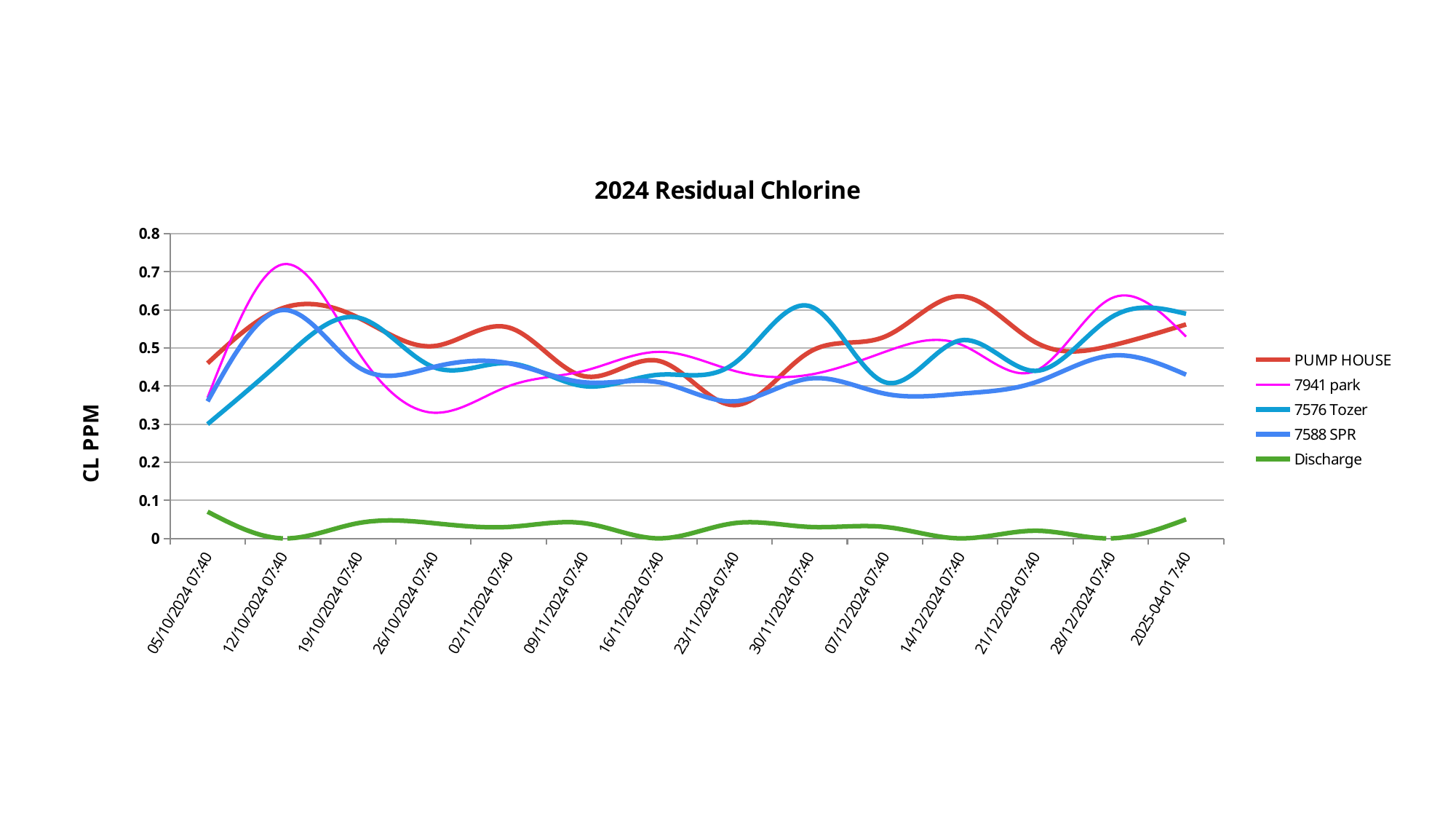
How many dates are shown along the x axis? 14 Which series has the lowest values across the whole chart? Discharge What is the label on the vertical axis? CL PPM Is the value for 7941 park at 12/10/2024 07:40 greater or less than 0.6? greater What is the title of the chart? 2024 Residual Chlorine Is the value for PUMP HOUSE at 14/12/2024 07:40 greater or less than 0.6? greater At 12/10/2024 07:40, which series has the highest value? 7941 park What kind of chart is shown on the slide? line chart Is the value for 7576 Tozer at 05/10/2024 07:40 greater or less than 0.4? less At 30/11/2024 07:40, which is larger, the value for 7576 Tozer or the value for 7588 SPR? 7576 Tozer How many series does the legend list? 5